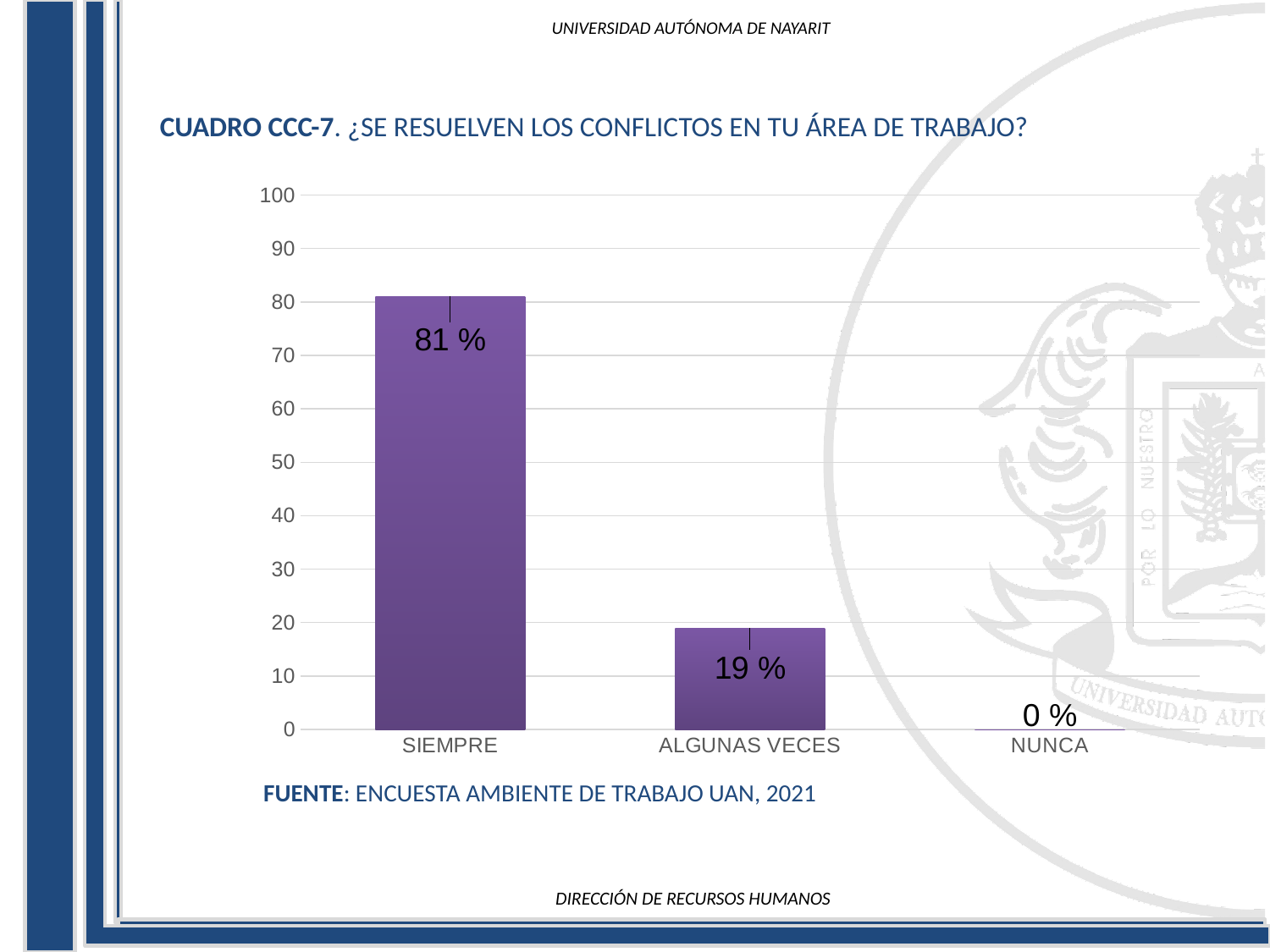
Which category has the highest value? SIEMPRE Which category has the lowest value? NUNCA Is the value for ALGUNAS VECES greater or less than 20? less How many categories are shown on the x axis? 3 Do the values rise or fall from left to right along the x axis? fall What is the value for NUNCA? 0 % What is the value for ALGUNAS VECES? 19 % What is the value for SIEMPRE? 81 % What kind of chart is shown on the slide? bar chart Is the value for SIEMPRE greater or less than 80? greater What is the difference between the values for SIEMPRE and ALGUNAS VECES? 62 % Which is larger, the value for SIEMPRE or the value for ALGUNAS VECES? SIEMPRE